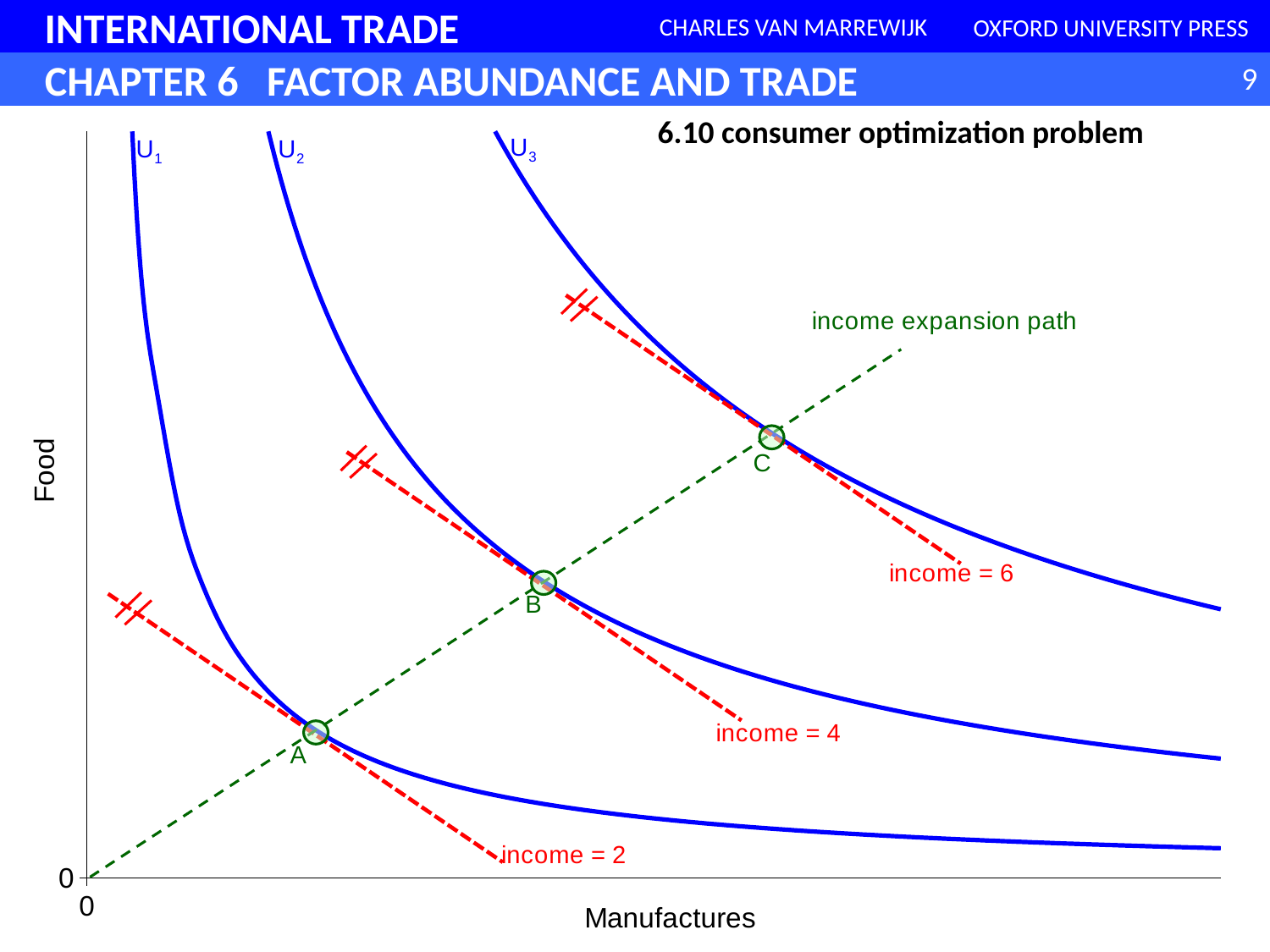
What is the title of the chart on the slide? 6.10 consumer optimization problem What income level corresponds to the budget line tangent at point C? income = 6 Which indifference curve passes through point C? U3 Do the indifference curves rise or fall as Manufactures increases along the x axis? fall What income level corresponds to the budget line tangent at point B? income = 4 Which labelled point, A or C, has the higher Food value? C What kind of chart is shown on the slide? line chart How many budget lines (income lines) are drawn on the chart? 3 What income level corresponds to the budget line tangent at point A? income = 2 What is the label of the vertical axis? Food Which labelled point, A or B, has the lower Manufactures value? A How many indifference curves (U curves) are drawn on the chart? 3